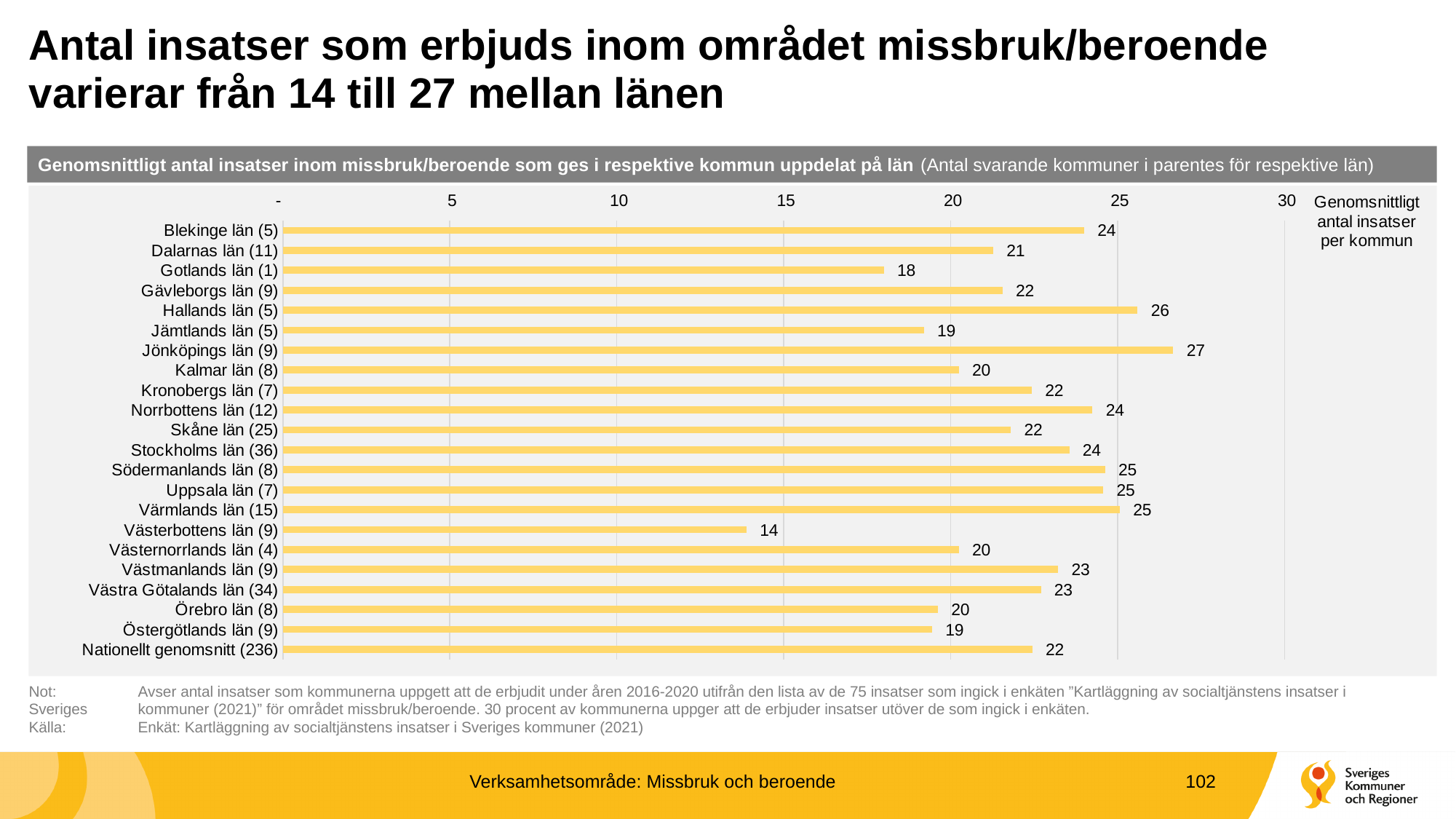
Is the value for Värmlands län (15) greater or less than 20? greater Which is larger, the value for Stockholms län (36) or the value for Dalarnas län (11)? Stockholms län (36) What is the difference between the values for Jönköpings län (9) and Västerbottens län (9)? 13 What is the difference between the values for Hallands län (5) and Jämtlands län (5)? 7 Which category has the lowest value? Västerbottens län (9) What kind of chart is shown on the slide? Bar chart Which category has the highest value? Jönköpings län (9) What is the value for Gotlands län (1)? 18 What is the value for Jönköpings län (9)? 27 How many bars are plotted in the chart? 22 What is the value for Nationellt genomsnitt (236)? 22 What is the value for Västerbottens län (9)? 14